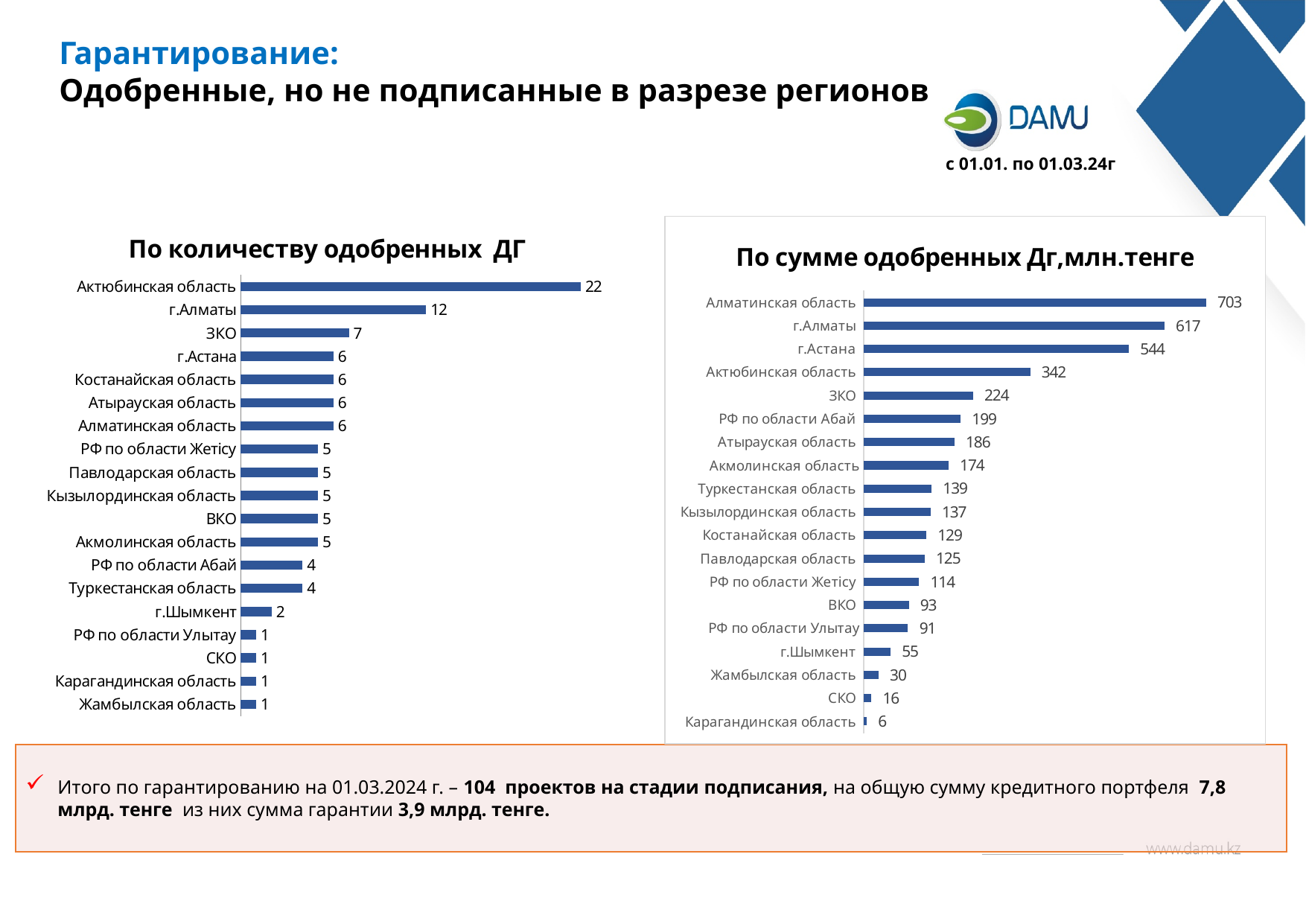
What is the title of the chart on the left side of the slide? По количеству одобренных ДГ In the chart 'По количеству одобренных ДГ', which region has the highest value? Актюбинская область In the chart 'По сумме одобренных Дг,млн.тенге', which region has the lowest value? Карагандинская область In the chart 'По количеству одобренных ДГ', how many regions are shown? 19 In the chart 'По сумме одобренных Дг,млн.тенге', which is larger, ЗКО or РФ по области Абай? ЗКО In the chart 'По сумме одобренных Дг,млн.тенге', what is the value for г.Астана? 544 In the chart 'По количеству одобренных ДГ', what is the value for Актюбинская область? 22 In the chart 'По количеству одобренных ДГ', what is the value for ЗКО? 7 What type of chart is 'По сумме одобренных Дг,млн.тенге'? bar chart In the chart 'По сумме одобренных Дг,млн.тенге', what is the value for Акмолинская область? 174 In the chart 'По количеству одобренных ДГ', what is the difference between Актюбинская область and г.Алматы? 10 In the chart 'По сумме одобренных Дг,млн.тенге', what is the difference between Алматинская область and г.Алматы? 86